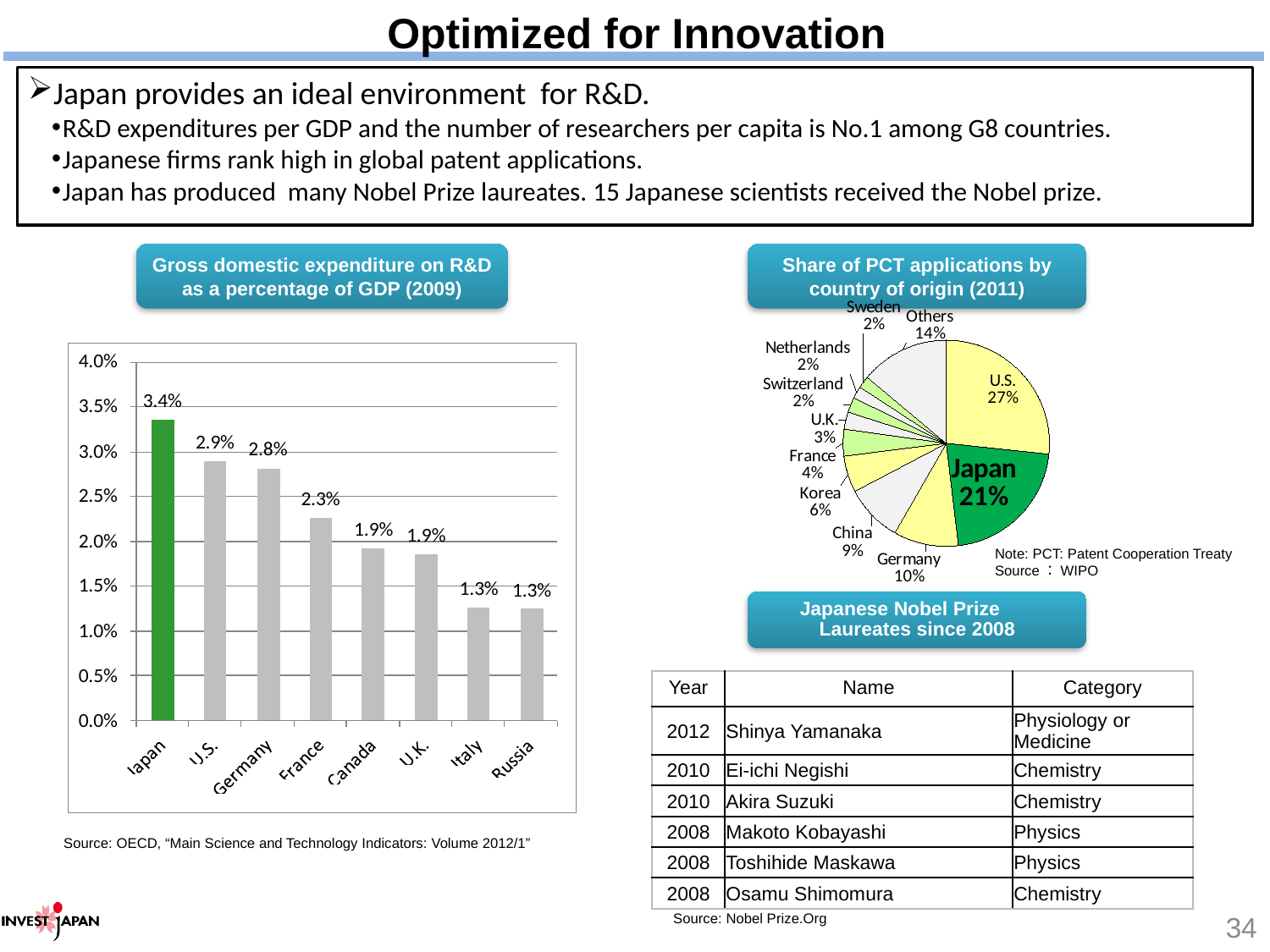
In the 'Gross domestic expenditure on R&D as a percentage of GDP (2009)' chart, what is the value for France? 2.3% What kind of chart is the 'Share of PCT applications by country of origin (2011)' chart? Pie chart In the 'Gross domestic expenditure on R&D as a percentage of GDP (2009)' chart, which country has the highest value? Japan In the 'Gross domestic expenditure on R&D as a percentage of GDP (2009)' chart, what is the difference between Japan and the U.S.? 0.5% In the 'Gross domestic expenditure on R&D as a percentage of GDP (2009)' chart, which is larger, Germany or Canada? Germany In the 'Share of PCT applications by country of origin (2011)' chart, what is the difference between the shares of Germany and China? 1% What kind of chart is the 'Gross domestic expenditure on R&D as a percentage of GDP (2009)' chart? Bar chart In the 'Share of PCT applications by country of origin (2011)' chart, what is Japan's share? 21% In the 'Gross domestic expenditure on R&D as a percentage of GDP (2009)' chart, what is the value for Japan? 3.4% How many countries are shown in the 'Gross domestic expenditure on R&D as a percentage of GDP (2009)' chart? 8 In the 'Share of PCT applications by country of origin (2011)' chart, which country has the largest share? U.S. In the 'Gross domestic expenditure on R&D as a percentage of GDP (2009)' chart, do the values rise or fall from left to right? Fall